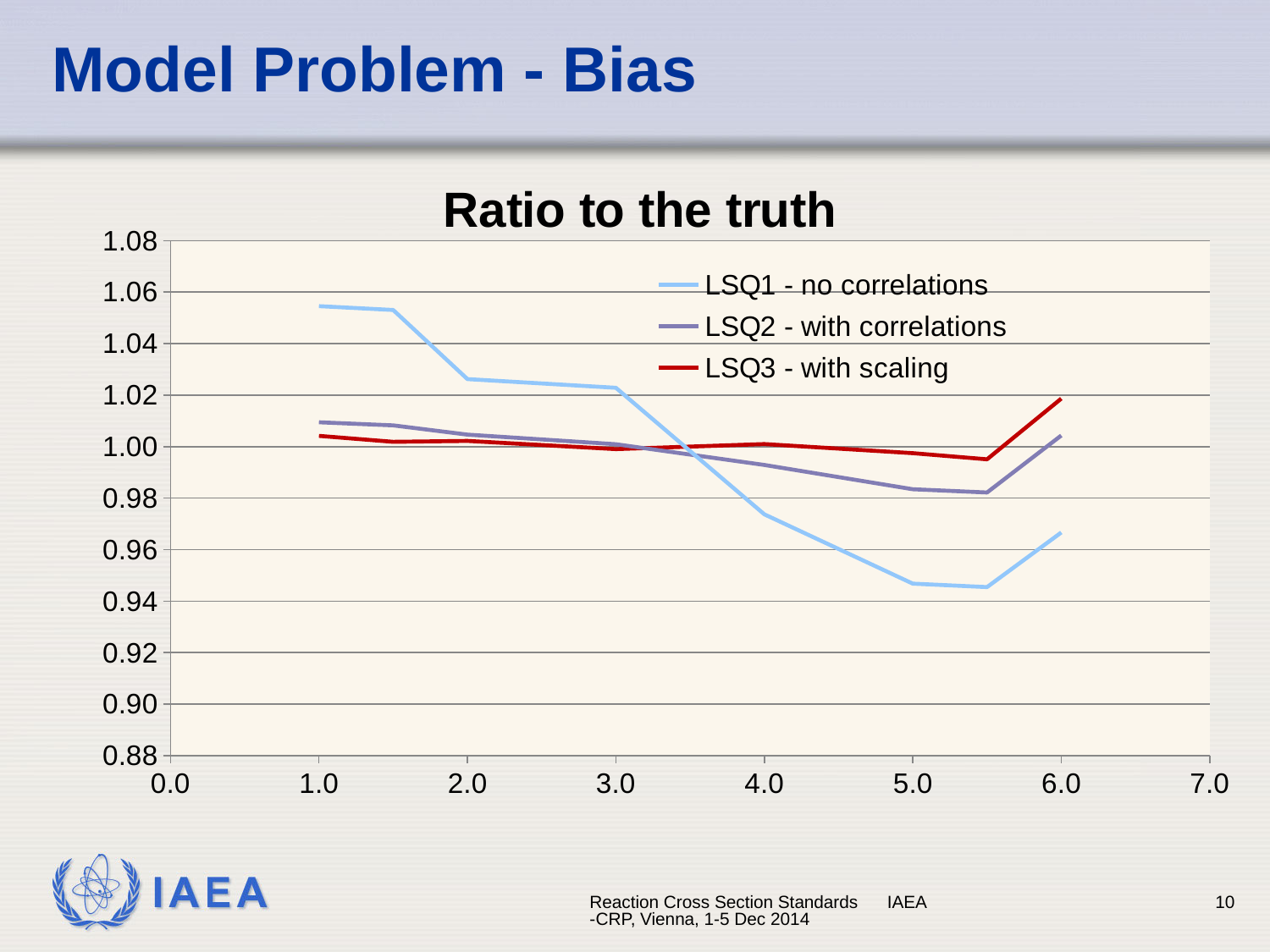
At x = 2.0, which series has the larger value, LSQ1 - no correlations or LSQ3 - with scaling? LSQ1 - no correlations Is the value of LSQ2 - with correlations at x = 5.5 greater or less than 1.00? less Is the value of LSQ1 - no correlations at x = 1.0 greater or less than 1.04? greater Does the LSQ1 - no correlations line rise or fall between x = 1.0 and x = 5.0? fall What is the title of the chart? Ratio to the truth Which series is drawn in red? LSQ3 - with scaling Is the value of LSQ3 - with scaling at x = 6.0 greater or less than 1.00? greater What kind of chart is shown under the title "Ratio to the truth"? line chart Which series has the highest value at x = 1.0? LSQ1 - no correlations How many series does the legend list? 3 Which series has the lowest value at x = 5.0? LSQ1 - no correlations